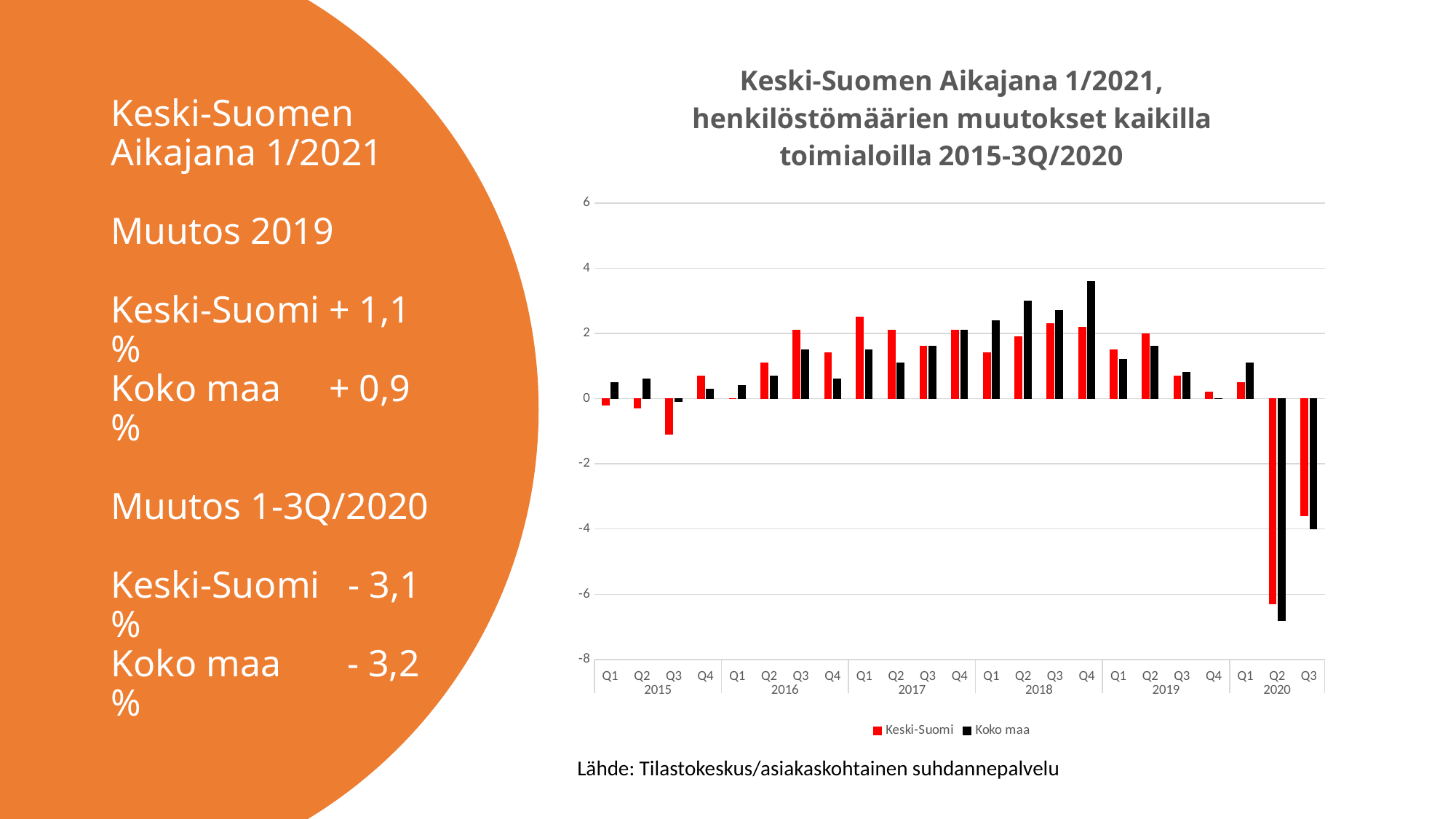
Which colour represents the Koko maa series in the chart? black How many quarterly categories are plotted along the x axis of the chart? 23 In Q1 2017, which series has the larger value, Keski-Suomi or Koko maa? Keski-Suomi What kind of chart is shown on the slide? bar chart Is the value for Koko maa in Q2 2020 greater or less than -6? less Is the value for Keski-Suomi in Q3 2015 greater or less than 0? less Is the value for Keski-Suomi in Q3 2020 greater or less than -2? less In which quarter does the Koko maa series reach its lowest value? Q2 2020 In Q4 2018, which series has the larger value, Keski-Suomi or Koko maa? Koko maa In which quarter does the Koko maa series reach its highest value? Q4 2018 How many series does the chart legend list? 2